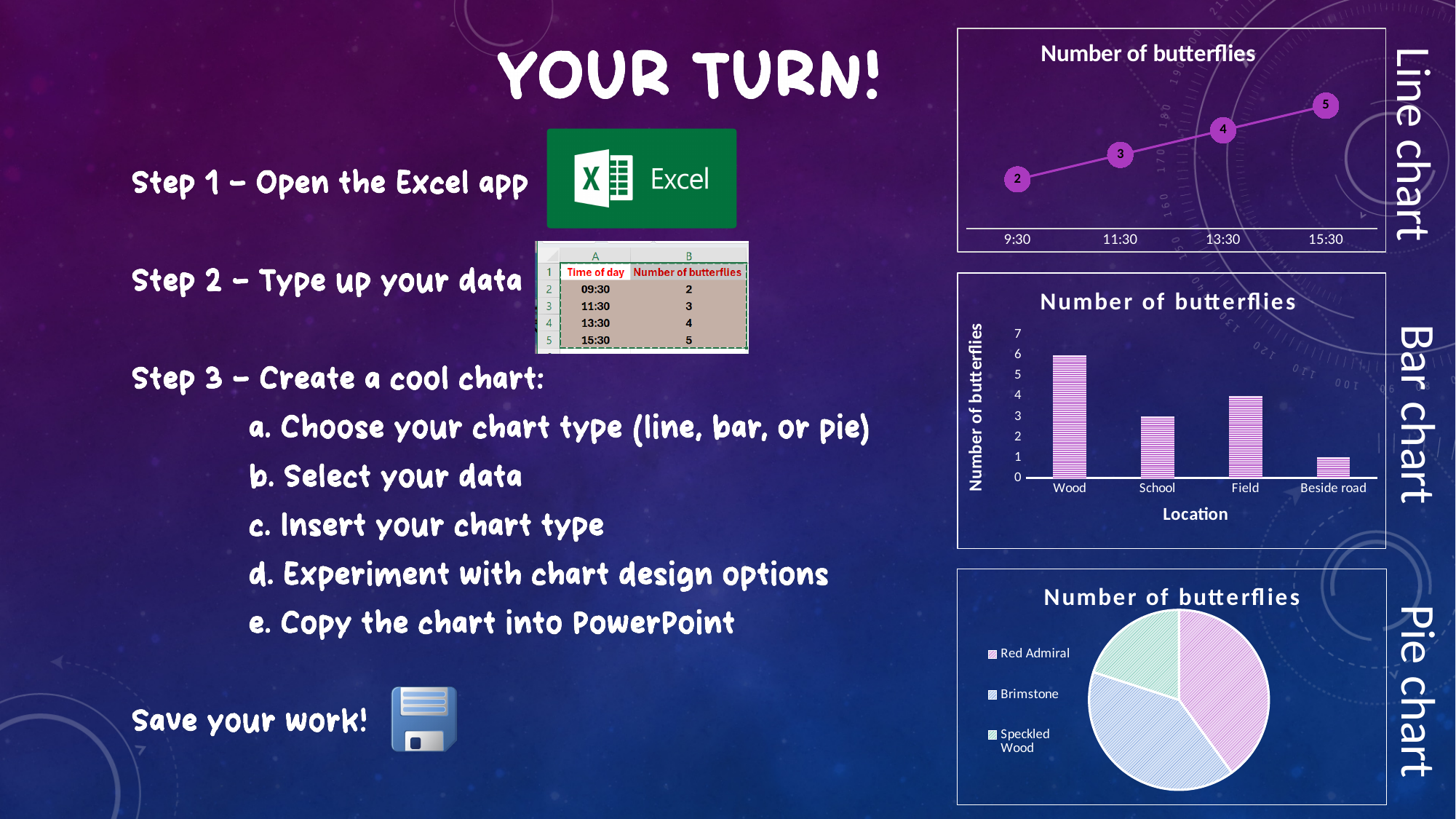
On the bar chart in the middle right, what is the label of the x axis? Location On the bar chart in the middle right, which is larger, the value for School or the value for Field? Field On the line chart at the top right, at which time is the number of butterflies highest? 15:30 On the pie chart at the bottom right, how many slices are there? 3 On the line chart at the top right, how many time points are plotted? 4 On the line chart at the top right, what is the number of butterflies at 13:30? 4 On the bar chart in the middle right, what is the difference between the values for Wood and School? 3 On the bar chart in the middle right, what is the number of butterflies for Wood? 6 On the line chart at the top right, what is the difference between the values at 15:30 and 9:30? 3 On the line chart at the top right, do the values rise or fall from 9:30 to 15:30? rise On the bar chart in the middle right, which location has the lowest number of butterflies? Beside road